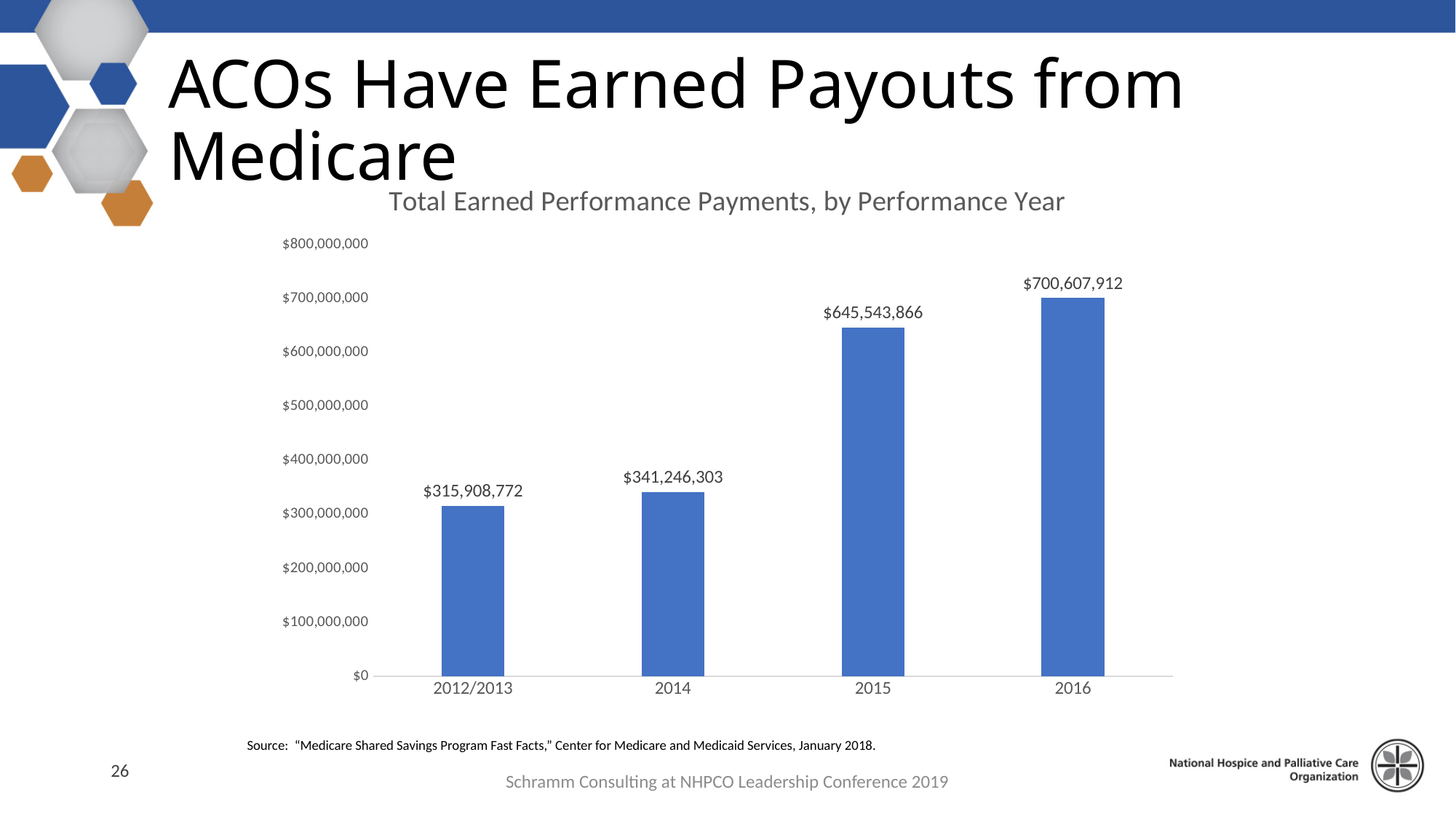
What is the total earned performance payment for 2016? $700,607,912 Which year had larger earned performance payments, 2014 or 2015? 2015 What is the difference between the earned performance payments for 2014 and 2012/2013? $25,337,531 Which performance year has the lowest total earned performance payments? 2012/2013 What is the difference between the earned performance payments for 2016 and 2015? $55,064,046 How many performance years are shown on the chart? 4 Which performance year has the highest total earned performance payments? 2016 What is the total earned performance payment for 2014? $341,246,303 What is the total earned performance payment for 2015? $645,543,866 What is the total earned performance payment for 2012/2013? $315,908,772 Is the value for 2015 greater or less than $600,000,000? greater What kind of chart is shown on the slide? Bar chart